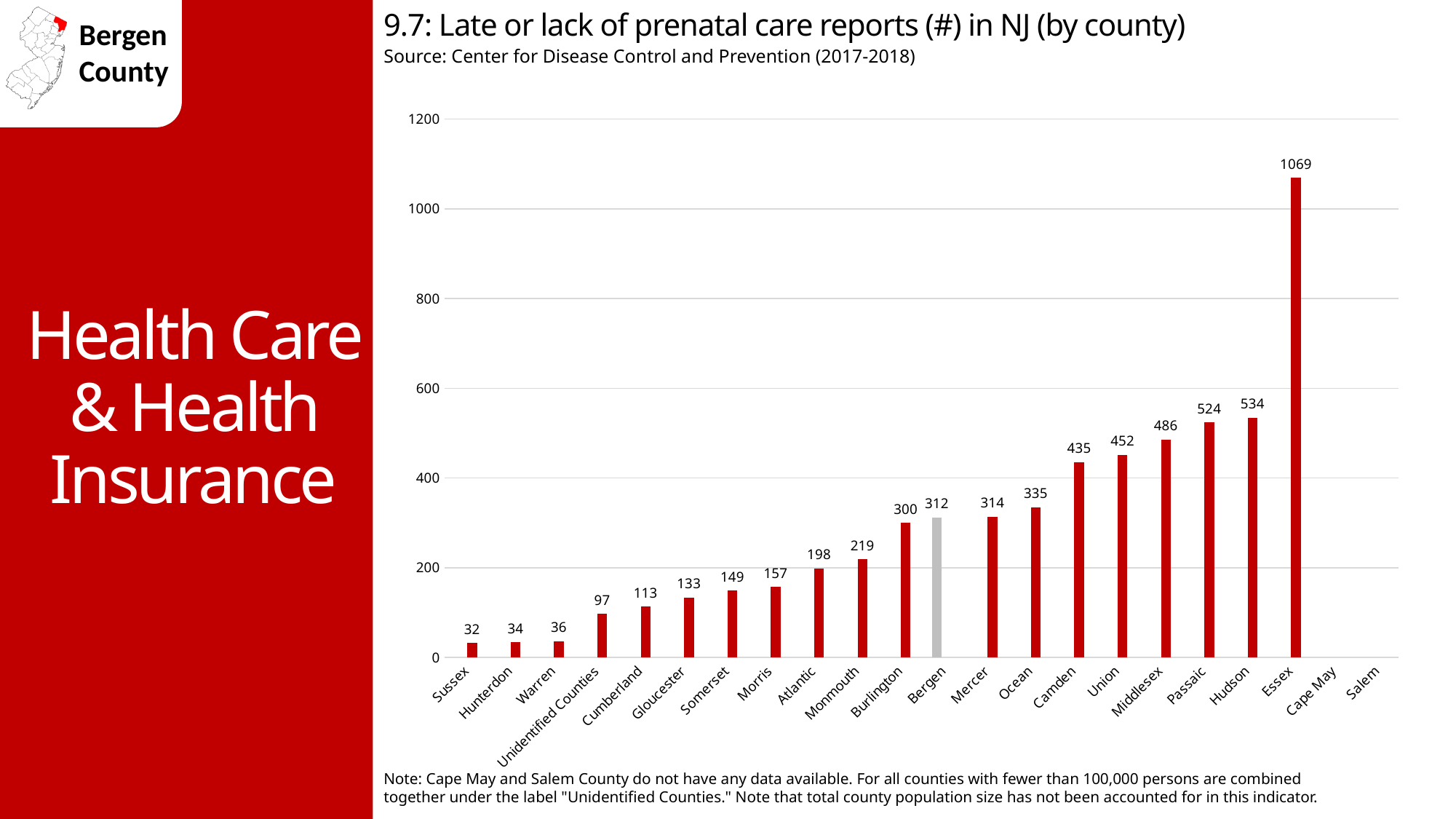
Do the values generally rise or fall from Sussex to Essex along the x axis? Rise How many categories are shown on the x axis of the chart? 22 What kind of chart is shown on the slide? Bar chart What is the difference between the values for Hudson and Passaic? 10 What is the number of late or lack of prenatal care reports for Bergen County? 312 Is the value for Middlesex greater or less than 400? greater Which county has the highest number of late or lack of prenatal care reports? Essex Which bar is coloured grey instead of red? Bergen What is the value shown for Essex County? 1069 What is the value shown for Unidentified Counties? 97 Which has a higher value, Camden or Union? Union Which county has the lowest number of late or lack of prenatal care reports among those with data? Sussex